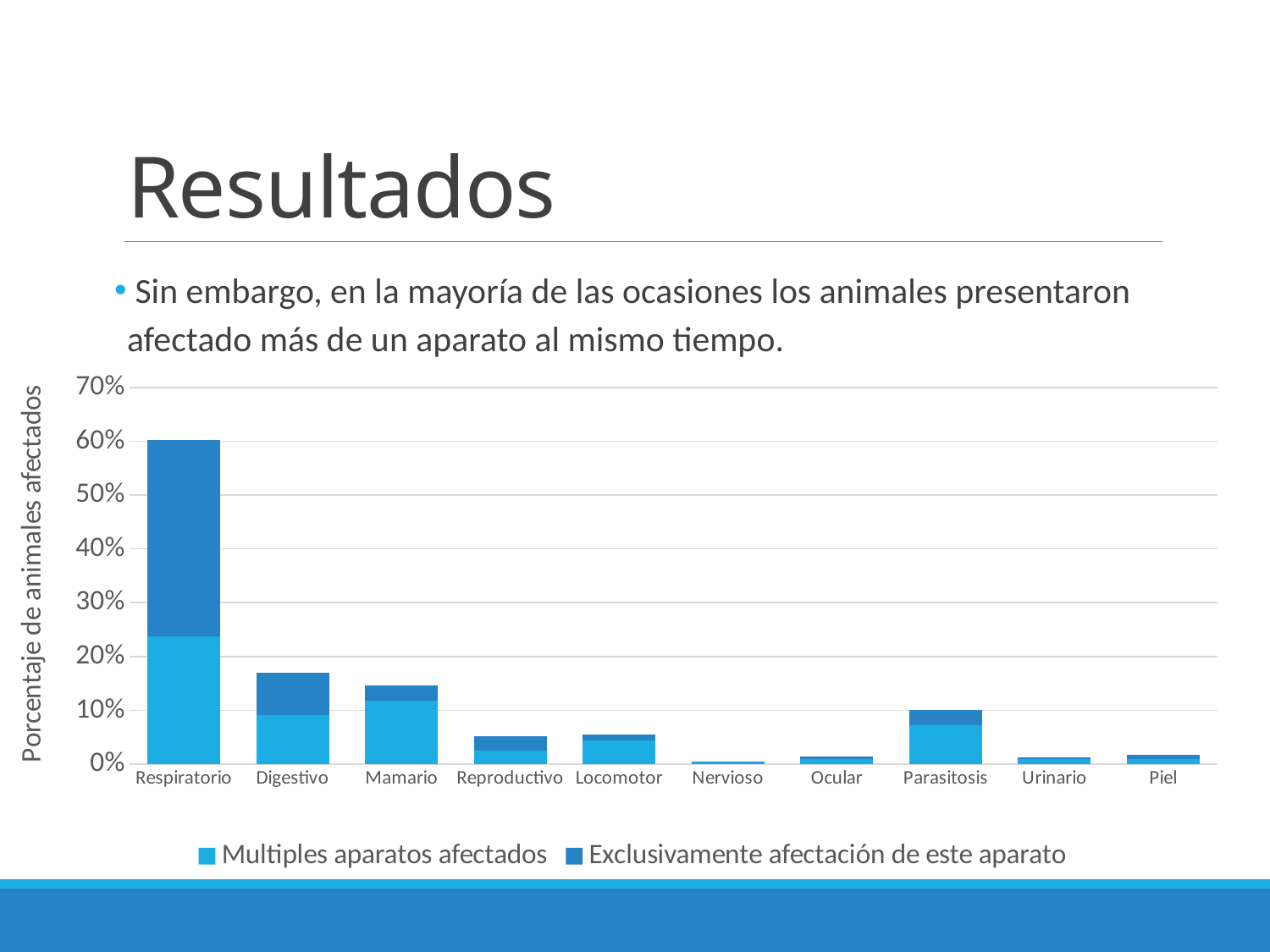
Which category has the highest total bar in the chart? Respiratorio Which category has the lowest total bar in the chart? Nervioso How many categories are shown on the x axis of the chart? 10 Which has the larger total bar, Digestivo or Mamario? Digestivo Is the total value for Respiratorio greater or less than 50%? greater What is the title of the chart's vertical axis? Porcentaje de animales afectados Is the total value for Digestivo greater or less than 10%? greater How many series does the chart's legend list? 2 What kind of chart is shown on the slide? bar chart Which has the larger total bar, Parasitosis or Urinario? Parasitosis Is the total value for Nervioso greater or less than 10%? less